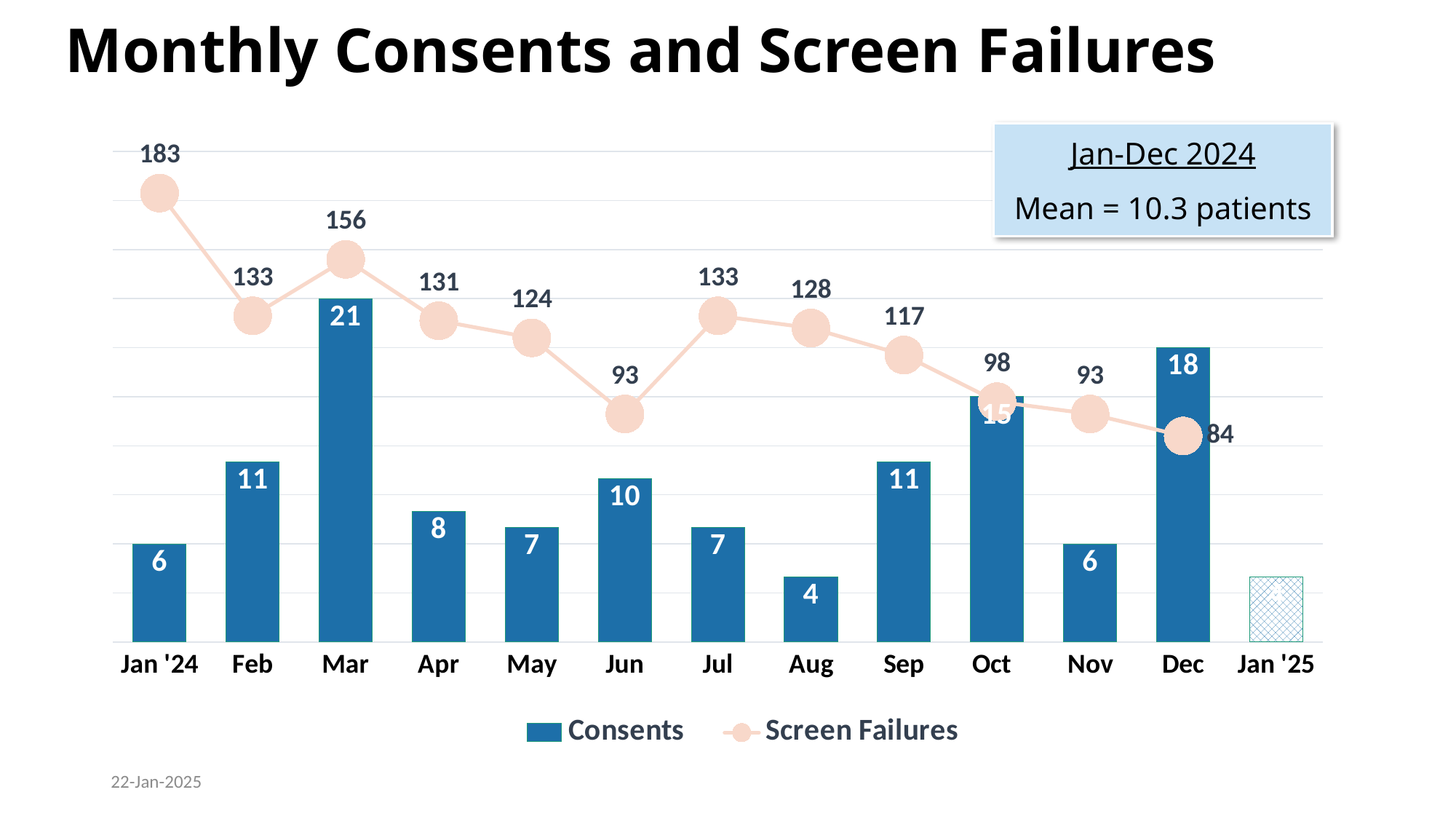
Overall, do the Screen Failures values rise or fall from January '24 to December? fall Which is larger, the Consents in October or the Consents in September? October What is the Screen Failures value for December? 84 How many series does the legend list? 2 What is the number of Consents in March? 21 What mean value is stated in the box for Jan-Dec 2024? 10.3 patients Which month has the highest Screen Failures value? Jan '24 What is the difference between the Screen Failures in March and in April? 25 What is the Screen Failures value for January '24? 183 Which month has the highest number of Consents? Mar What is the difference between the Consents in December and in November? 12 Which month has the lowest number of Consents? Aug